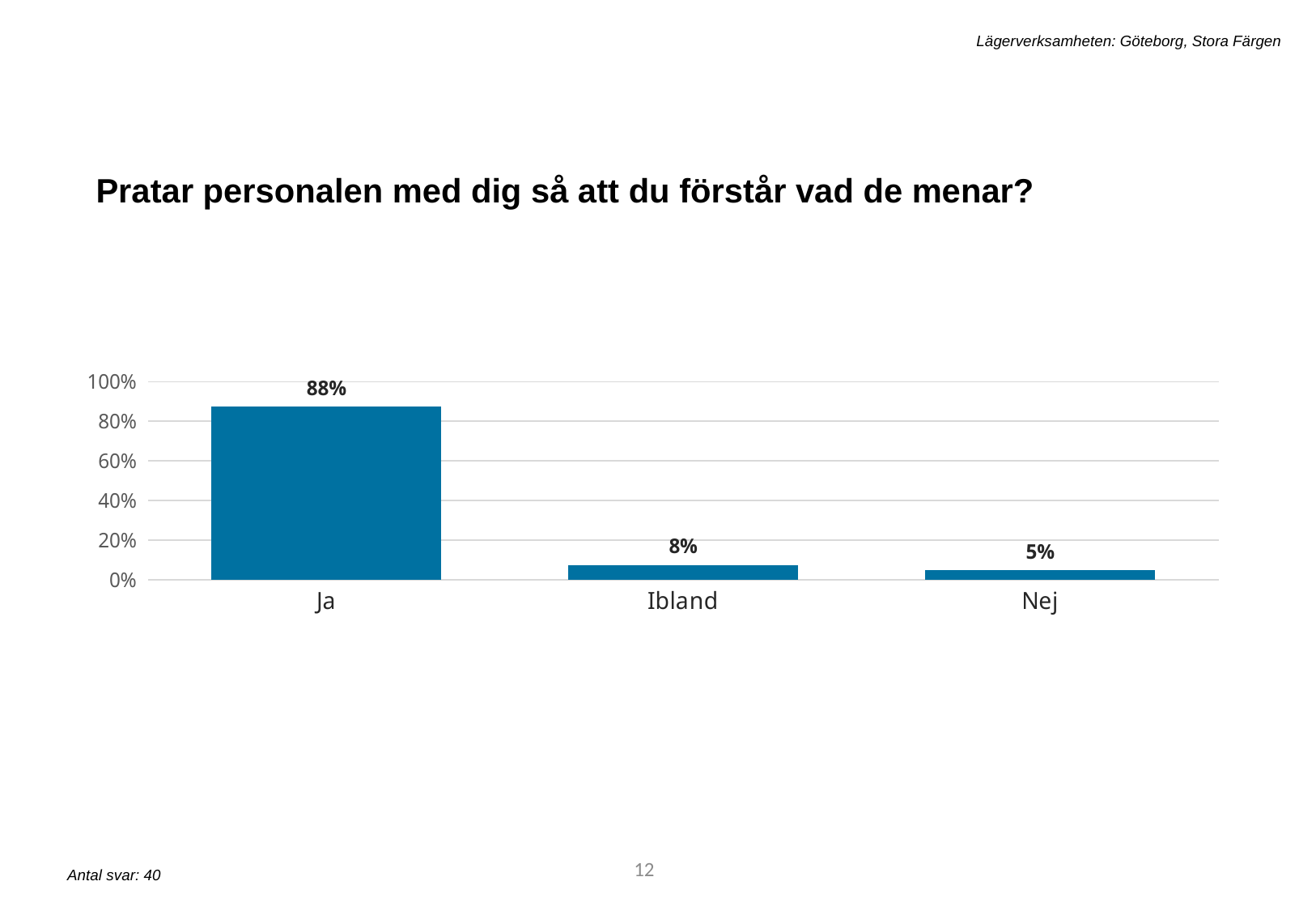
How many categories are shown on the x axis? 3 What is the difference between the values for Ibland and Nej? 3 percentage points What is the value for Ibland? 8% What is the value for Nej? 5% Which category has the highest value? Ja Is the value for Ja greater or less than 80%? greater What is the title of the chart? Pratar personalen med dig så att du förstår vad de menar? What is the value for Ja? 88% Which is larger, the value for Ibland or the value for Nej? Ibland Which category has the lowest value? Nej What kind of chart is shown on the slide? bar chart What is the difference between the values for Ja and Ibland? 80 percentage points